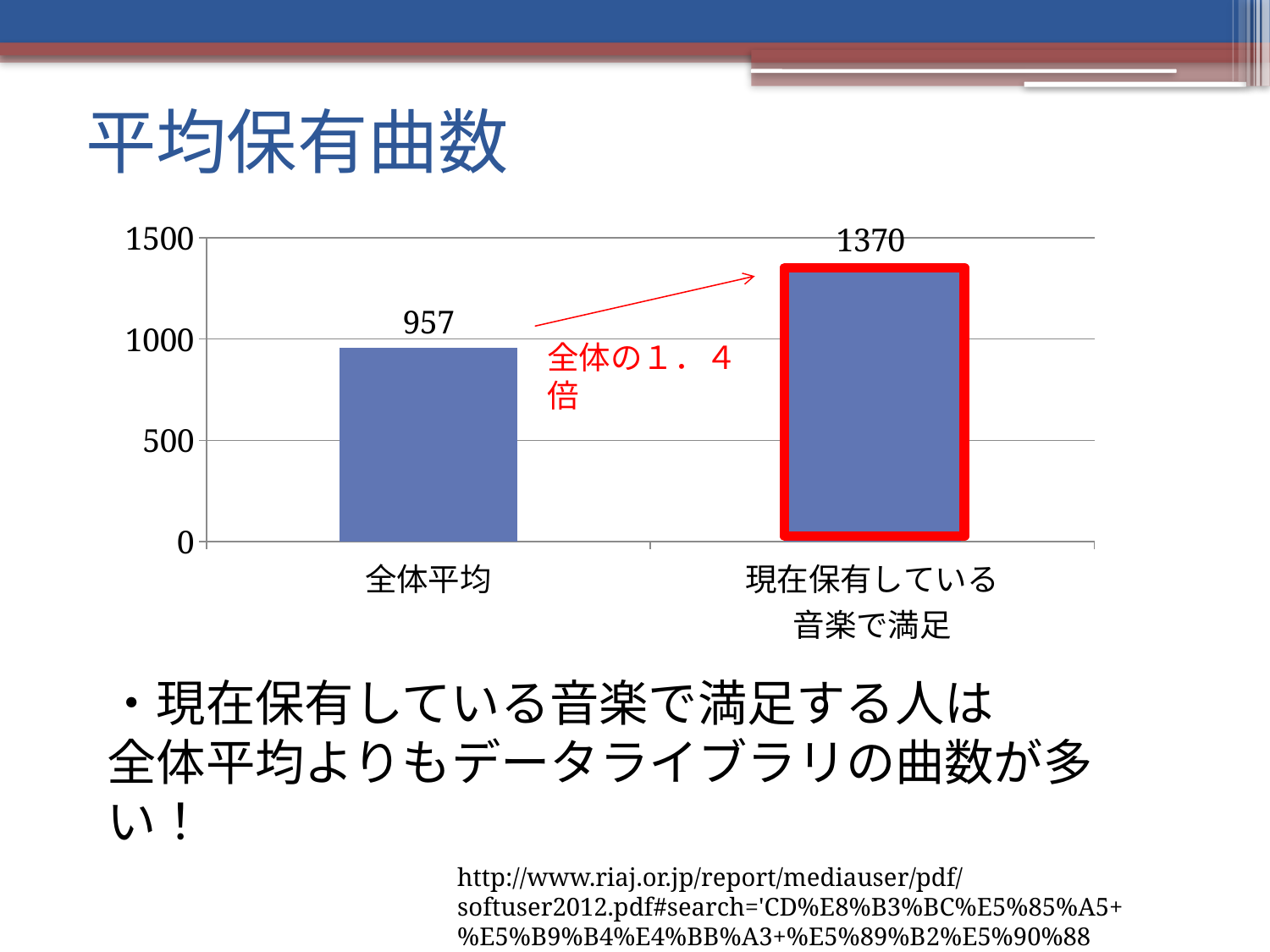
Which category has the lowest value? 全体平均 What is the difference between the values for 現在保有している音楽で満足 and 全体平均? 413 Which is larger, the value for 全体平均 or the value for 現在保有している音楽で満足? 現在保有している音楽で満足 What is the value for 全体平均? 957 How many categories are shown in the chart? 2 What is the title of the slide containing the chart? 平均保有曲数 Is the value for 全体平均 greater or less than 1000? less What is the value for 現在保有している音楽で満足? 1370 What kind of chart is shown on the slide? bar chart Is the value for 現在保有している音楽で満足 greater or less than 1000? greater Which category has the highest value? 現在保有している音楽で満足 What is the highest value shown on the vertical axis? 1500